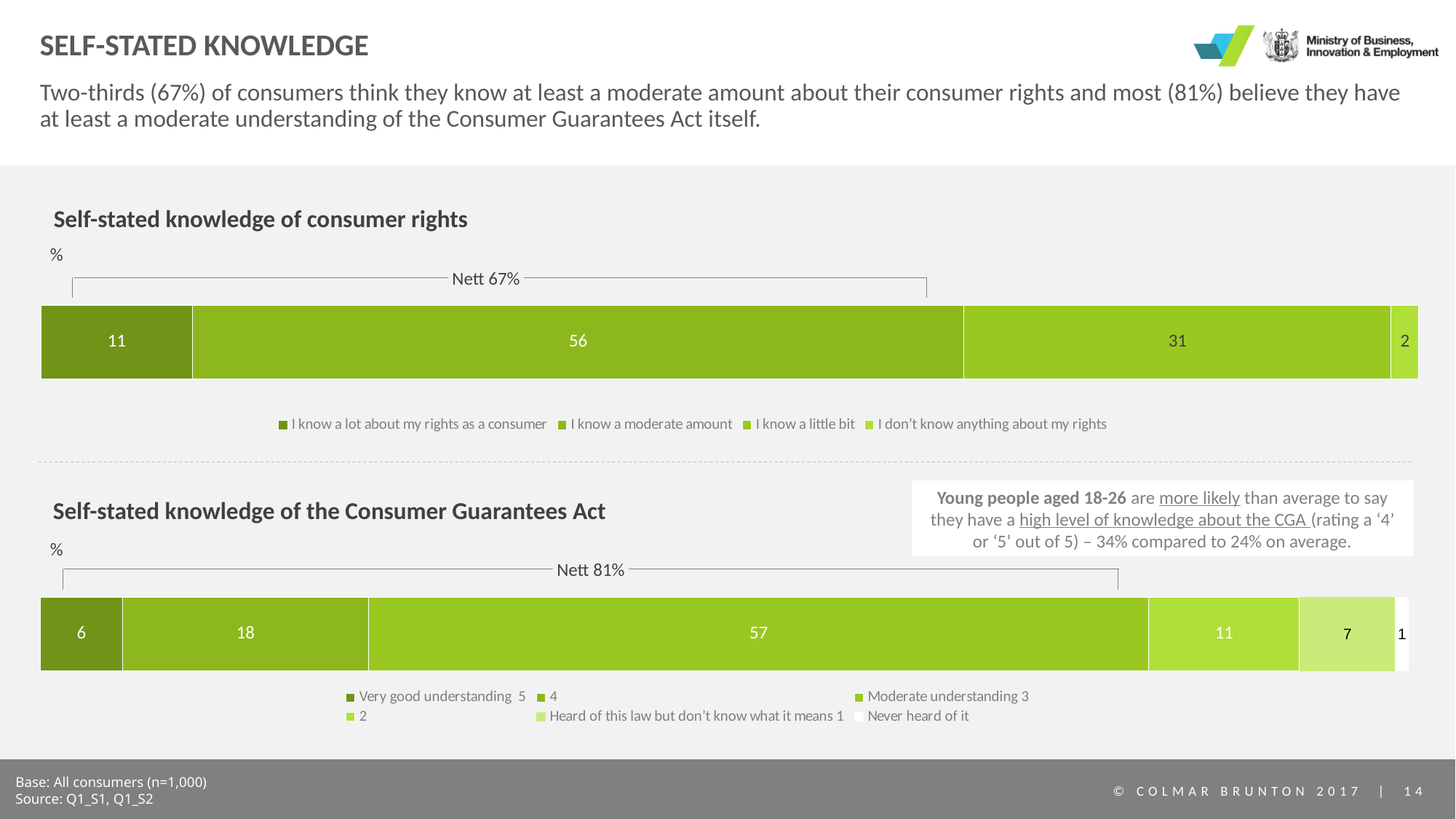
In the 'Self-stated knowledge of consumer rights' chart, what percentage of consumers say 'I know a moderate amount'? 56 In the 'Self-stated knowledge of consumer rights' chart, what is the difference between 'I know a moderate amount' and 'I know a little bit'? 25 In the 'Self-stated knowledge of the Consumer Guarantees Act' chart, what is the value for 'Moderate understanding 3'? 57 In the 'Self-stated knowledge of consumer rights' chart, what is the value for 'I know a little bit'? 31 In the 'Self-stated knowledge of the Consumer Guarantees Act' chart, what is the value for 'Heard of this law but don't know what it means 1'? 7 In the 'Self-stated knowledge of consumer rights' chart, which response has the largest segment? I know a moderate amount In the 'Self-stated knowledge of the Consumer Guarantees Act' chart, which is larger: the value for '4' or the value for '2'? 4 What type of chart is used for 'Self-stated knowledge of the Consumer Guarantees Act'? Stacked bar chart How many categories does the legend of the 'Self-stated knowledge of consumer rights' chart list? 4 In the 'Self-stated knowledge of the Consumer Guarantees Act' chart, what is the value for 'Very good understanding 5'? 6 How many categories does the legend of the 'Self-stated knowledge of the Consumer Guarantees Act' chart list? 6 In the 'Self-stated knowledge of consumer rights' chart, which response has the smallest segment? I don't know anything about my rights